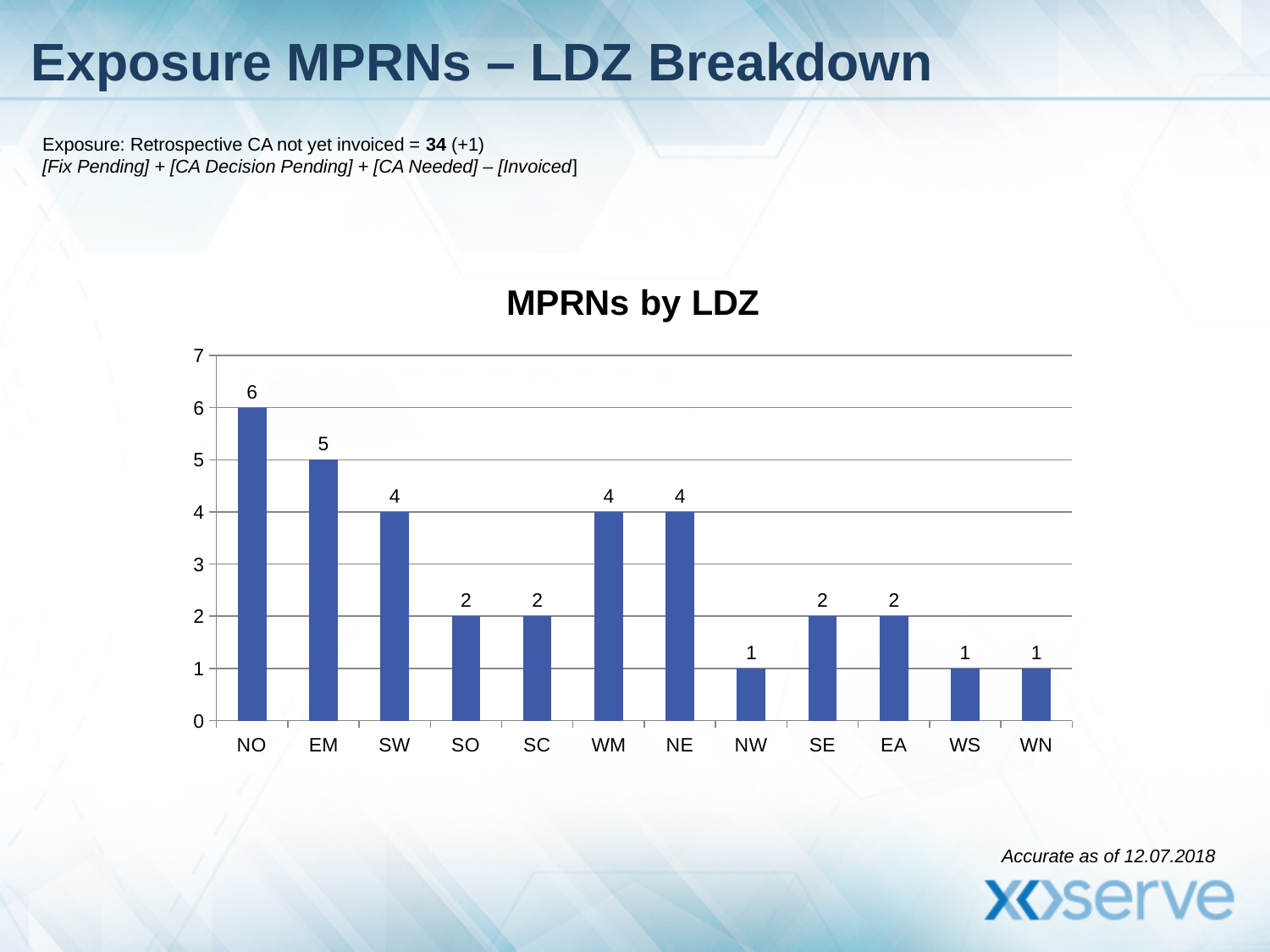
What is the difference between the values for SW and SO in the MPRNs by LDZ chart? 2 Is the value for EM greater or less than 3 in the MPRNs by LDZ chart? greater Which LDZ has the highest value in the MPRNs by LDZ chart? NO What is the value for NW in the MPRNs by LDZ chart? 1 What is the value for EM in the MPRNs by LDZ chart? 5 What kind of chart is the MPRNs by LDZ chart? bar chart What is the difference between the values for NO and EM in the MPRNs by LDZ chart? 1 What is the highest value shown on the y axis of the MPRNs by LDZ chart? 7 Which is larger in the MPRNs by LDZ chart, the value for WM or the value for SE? WM What is the title of the chart on the slide? MPRNs by LDZ What is the value for NO in the MPRNs by LDZ chart? 6 How many LDZ categories are shown on the x axis of the MPRNs by LDZ chart? 12